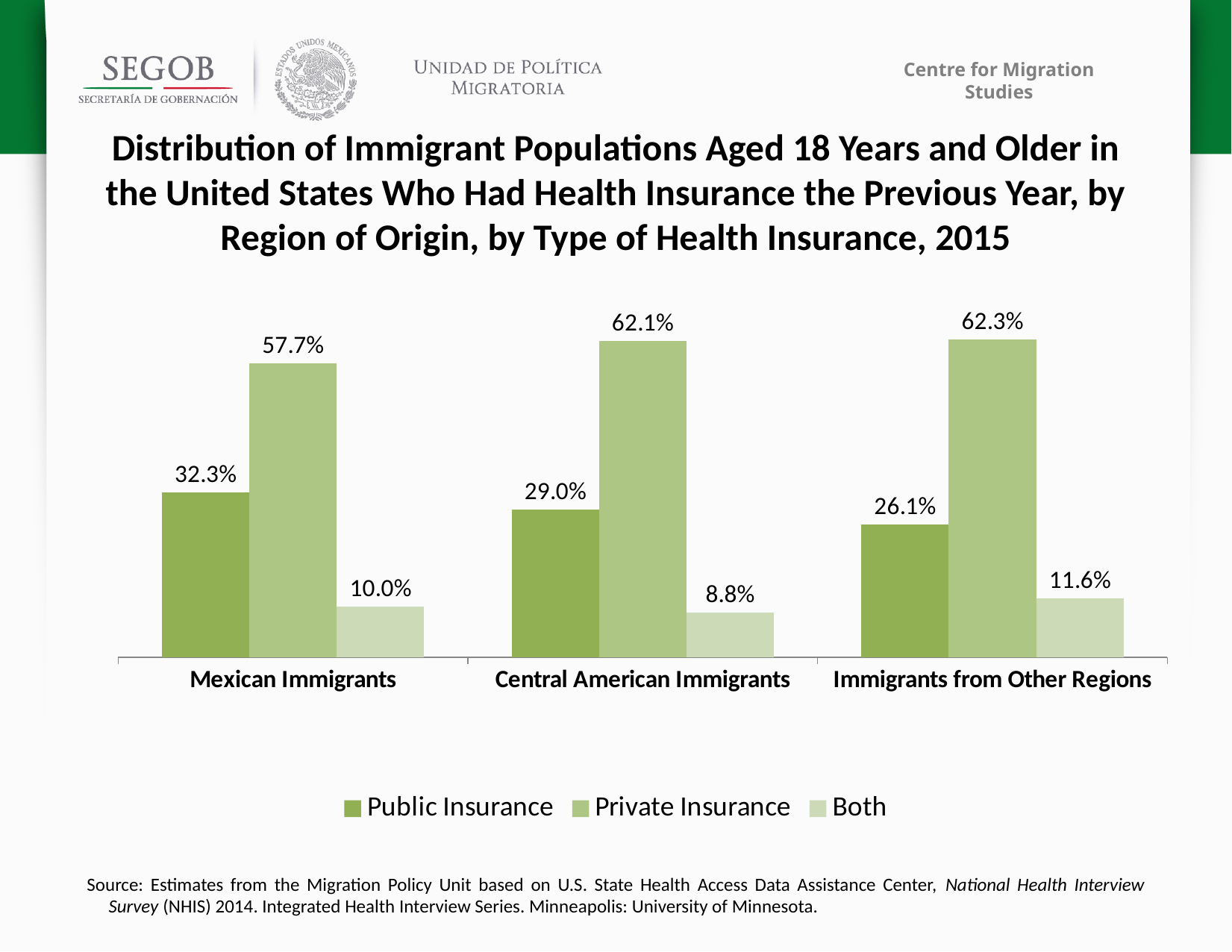
What is the Private Insurance value for Central American Immigrants? 62.1% How many regions of origin are shown on the x axis? 3 What is the value for Both for Immigrants from Other Regions? 11.6% Does the Public Insurance value rise or fall from Mexican Immigrants to Immigrants from Other Regions? Fall Which region has the highest Public Insurance value? Mexican Immigrants Which is larger: the Both value for Mexican Immigrants or for Central American Immigrants? Mexican Immigrants What are the three series listed in the legend? Public Insurance, Private Insurance, Both What is the Public Insurance value for Mexican Immigrants? 32.3% What is the difference between the Private Insurance and Public Insurance values for Mexican Immigrants? 25.4% How many series does the legend list? 3 Which region has the lowest value for Both? Central American Immigrants What kind of chart is shown on the slide? Bar chart